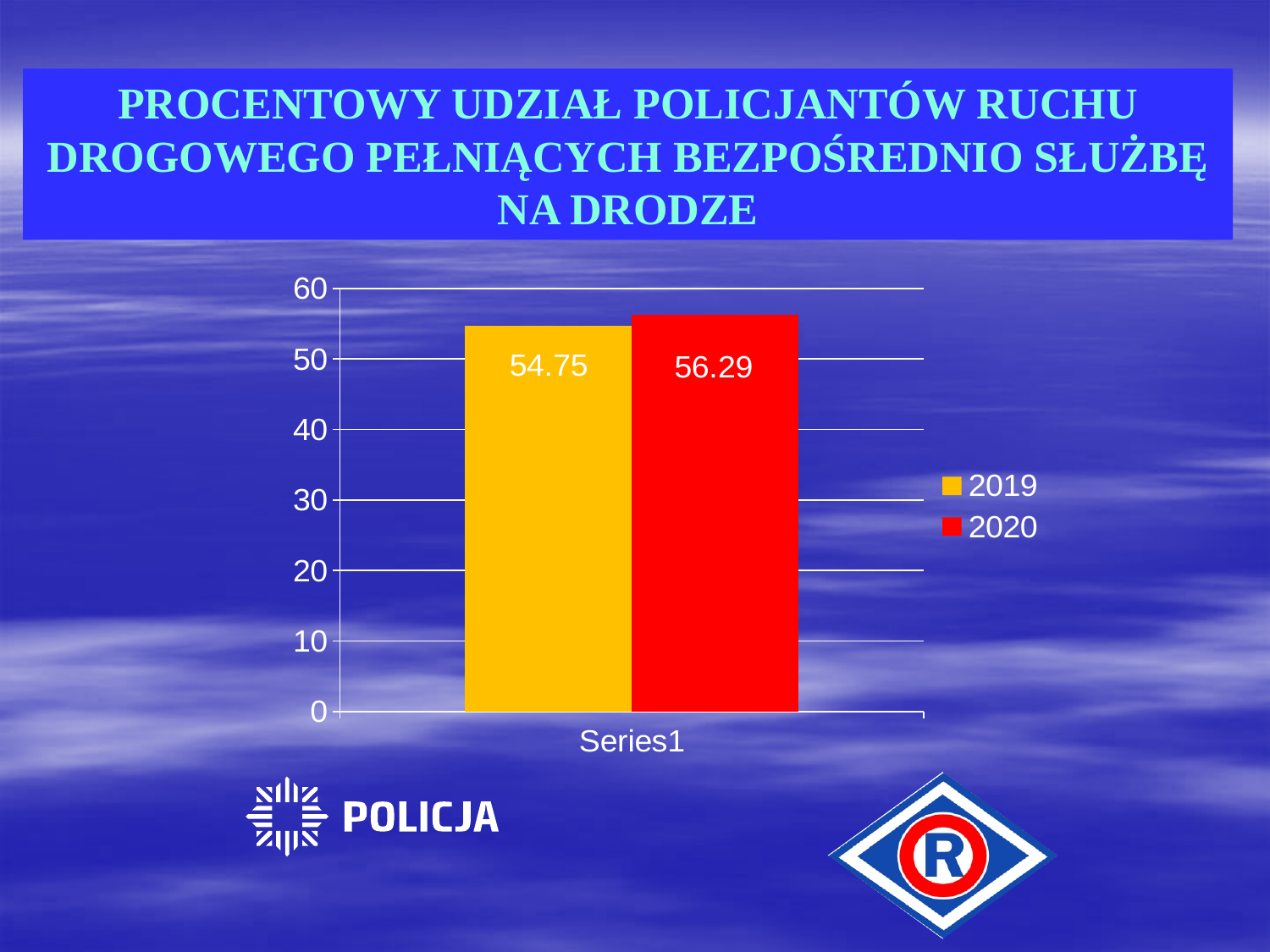
What is the value for 2020? 56.29 How many series does the legend list? 2 Is the value for 2019 greater or less than 50? greater What colour is the bar for 2020? red What is the category label shown on the x axis? Series1 What kind of chart is shown on the slide? bar chart Which series has the highest value? 2020 Which year has the higher value, 2019 or 2020? 2020 Is the value for 2020 greater or less than 60? less What is the value for 2019? 54.75 Which series has the lowest value? 2019 What is the difference between the 2020 value and the 2019 value? 1.54